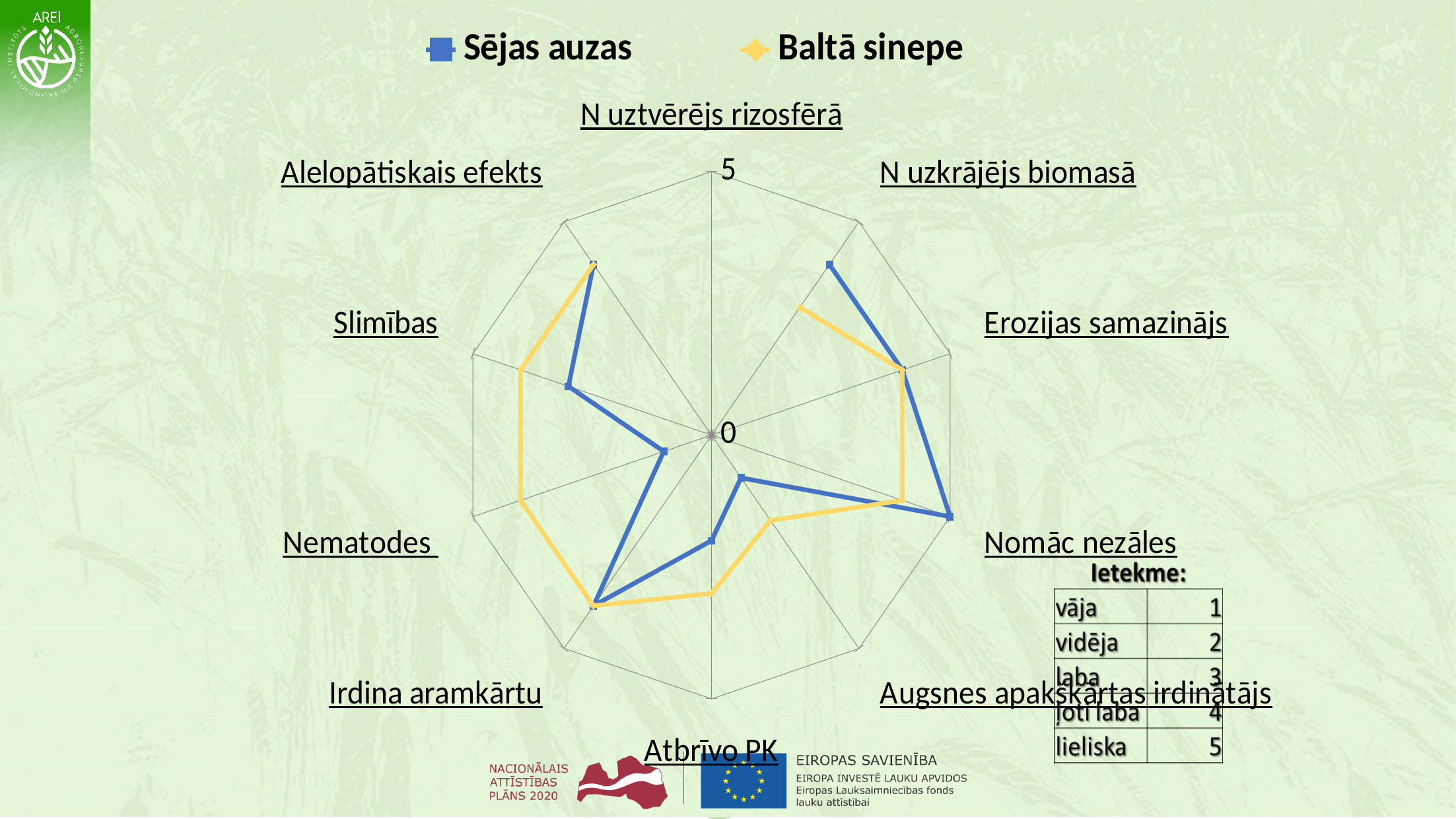
Which series is shown in yellow in the legend? Baltā sinepe What is the value for Sējas auzas on the Nomāc nezāles axis? 5 On the N uzkrājējs biomasā axis, which series has the larger value, Sējas auzas or Baltā sinepe? Sējas auzas What kind of chart is shown on the slide? radar chart How many categories (axes) does the radar chart have? 10 How many series does the legend list? 2 What is the maximum value shown on the radar chart's axis scale? 5 On the Slimības axis, which series has the larger value, Sējas auzas or Baltā sinepe? Baltā sinepe On which axis does Sējas auzas reach its highest value? Nomāc nezāles On the Nematodes axis, which series has the larger value, Sējas auzas or Baltā sinepe? Baltā sinepe